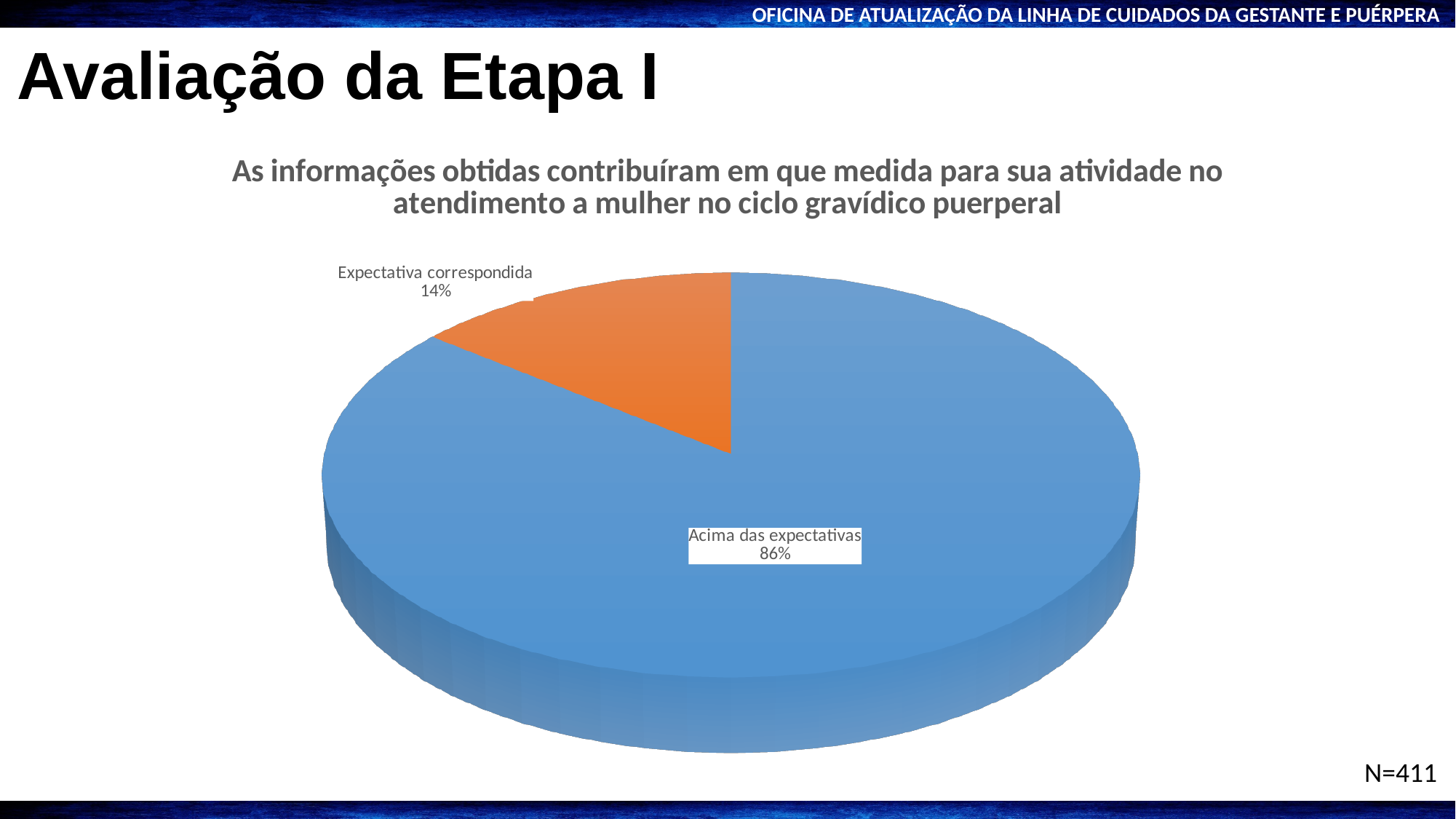
What kind of chart is shown on the slide? Pie chart What share of the pie does "Acima das expectativas" represent? 86% Which category has the largest slice of the pie? Acima das expectativas Which category has the smallest slice of the pie? Expectativa correspondida Which is larger: the slice for "Acima das expectativas" or the slice for "Expectativa correspondida"? Acima das expectativas What share of the pie does "Expectativa correspondida" represent? 14% Is the share for "Expectativa correspondida" greater or less than 50%? less What colour is the slice for "Acima das expectativas"? Blue How many categories are shown in the pie chart? 2 What is the sample size (N) noted on the slide? N=411 What is the difference in percentage points between "Acima das expectativas" and "Expectativa correspondida"? 72